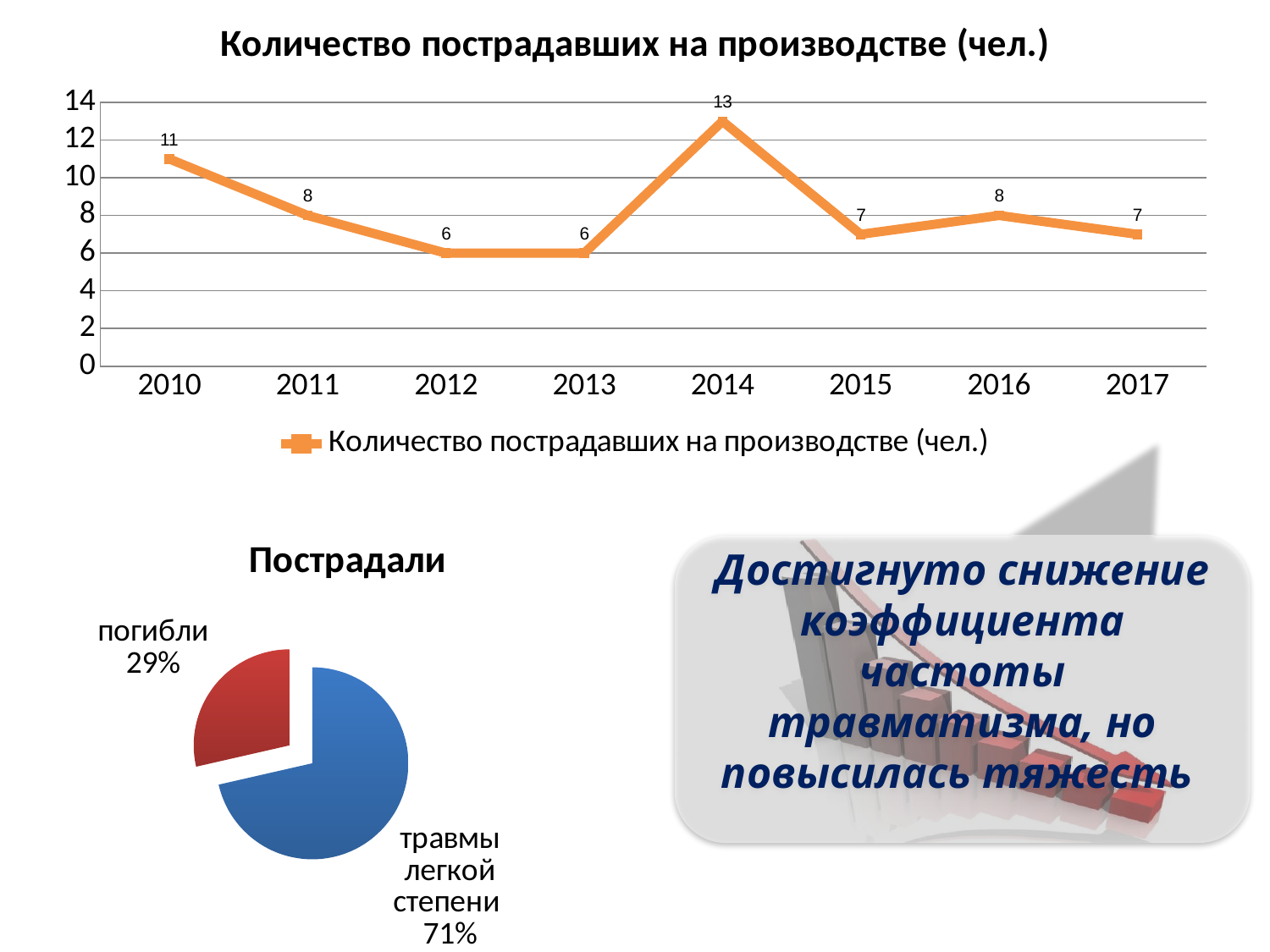
What kind of chart is the chart titled 'Пострадали'? pie chart In the line chart 'Количество пострадавших на производстве (чел.)', do the values rise or fall from 2010 to 2012? fall In the pie chart 'Пострадали', what share does 'погибли' have? 29% In the line chart 'Количество пострадавших на производстве (чел.)', which is larger, the value for 2011 or the value for 2017? 2011 In the line chart 'Количество пострадавших на производстве (чел.)', how many years are plotted on the x axis? 8 What kind of chart is the top chart on the slide? line chart In the line chart 'Количество пострадавших на производстве (чел.)', what is the value for 2014? 13 In the line chart 'Количество пострадавших на производстве (чел.)', what is the value for 2010? 11 In the pie chart 'Пострадали', what share does 'травмы легкой степени' have? 71% In the line chart 'Количество пострадавших на производстве (чел.)', how many series does the legend list? 1 In the line chart 'Количество пострадавших на производстве (чел.)', what is the difference between the values for 2014 and 2015? 6 In the line chart 'Количество пострадавших на производстве (чел.)', which year has the highest value? 2014